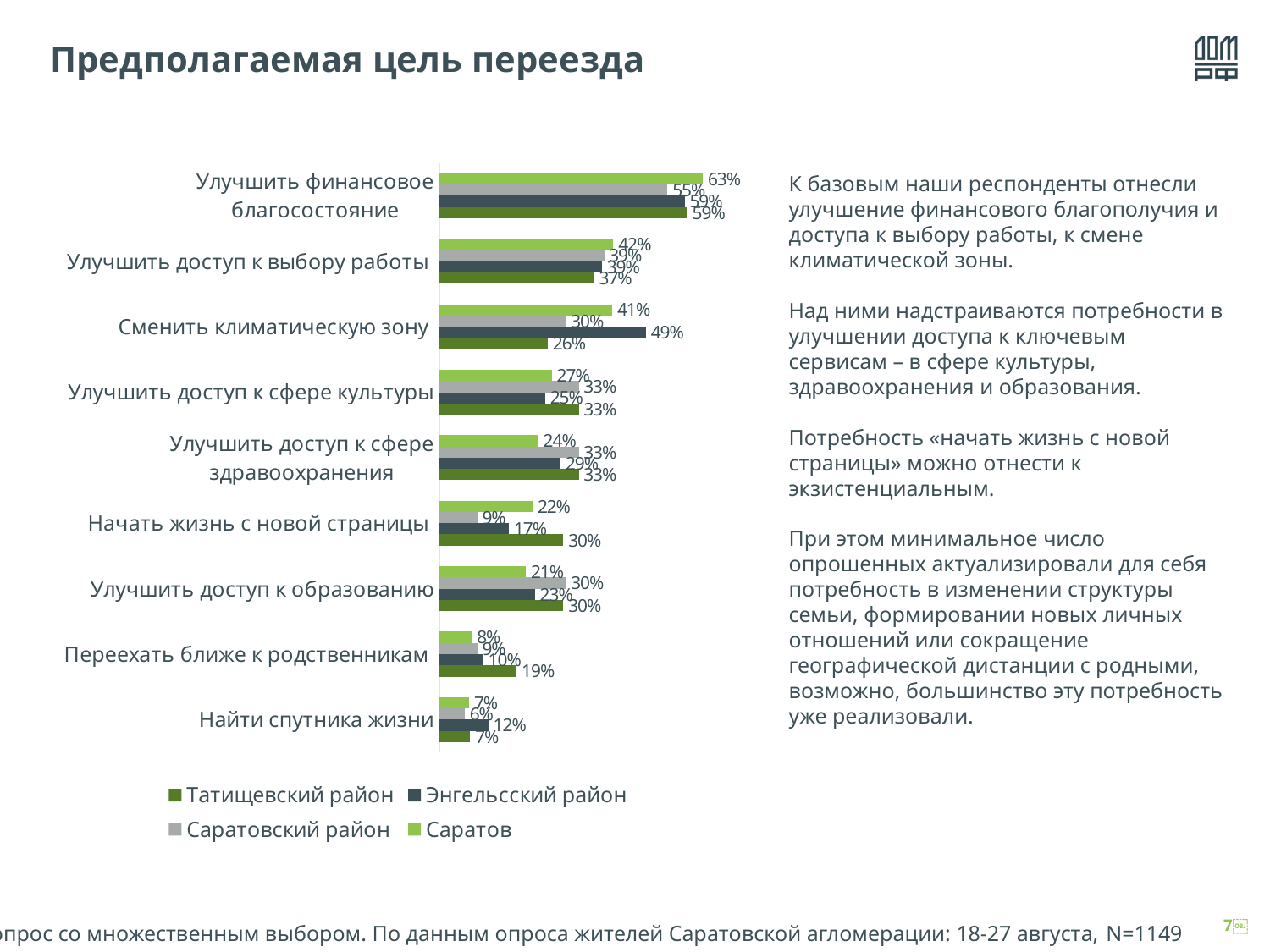
How many series does the legend list? 4 Which series is shown in light green in the legend? Саратов What is the value for Саратов in the category 'Улучшить финансовое благосостояние'? 63% How many categories (goals of relocation) are shown on the chart? 9 What type of chart is shown on the slide? bar chart In the category 'Найти спутника жизни', which is larger: the value for Энгельсский район or for Саратов? Энгельсский район What is the value for Татищевский район in the category 'Начать жизнь с новой страницы'? 30% Which series has the lowest value in the category 'Начать жизнь с новой страницы'? Саратовский район What is the value for Татищевский район in the category 'Переехать ближе к родственникам'? 19% What is the difference between the Энгельсский район and Татищевский район values in the category 'Сменить климатическую зону'? 23% What is the value for Энгельсский район in the category 'Сменить климатическую зону'? 49% Which series has the highest value in the category 'Сменить климатическую зону'? Энгельсский район